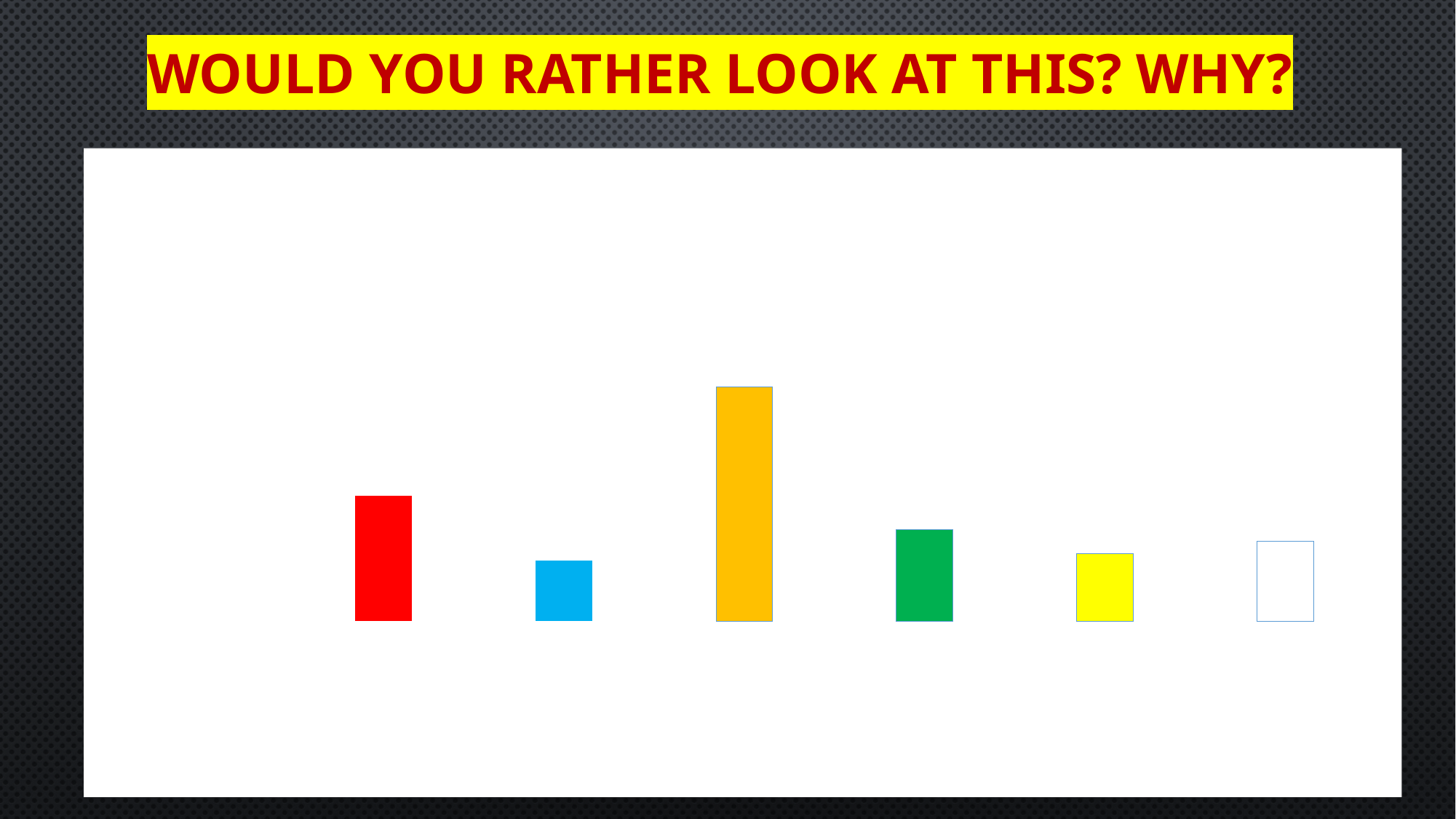
Which coloured bar is the tallest in the chart? Orange How many bars does the chart contain? 6 What kind of chart is shown on the slide? Bar chart Which is taller, the orange bar or the red bar? Orange Does the chart show any axis labels or data labels? No Which is taller, the red bar or the white bar? Red Which is taller, the red bar or the green bar? Red What colour is the third bar from the left? Orange